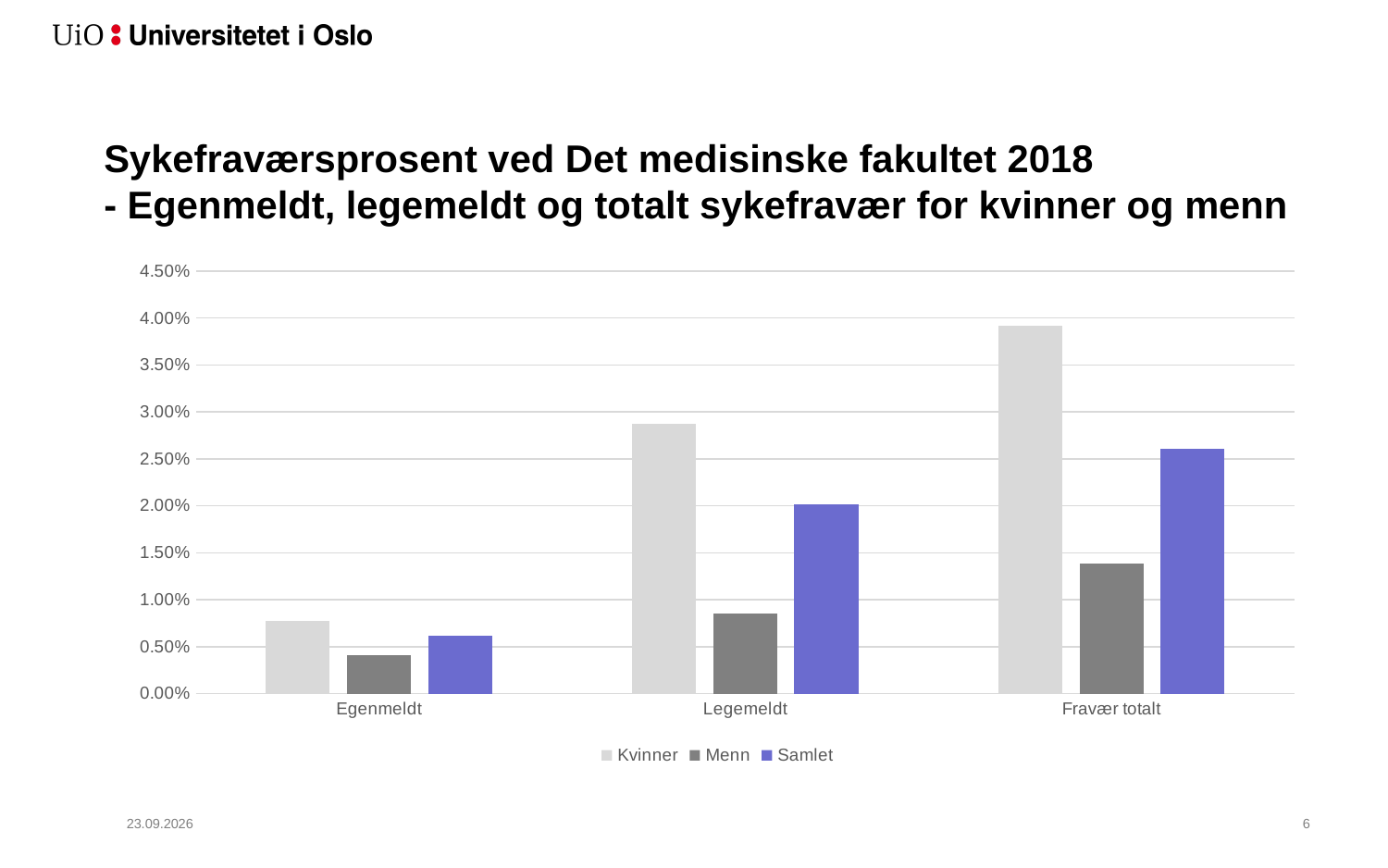
How many categories are shown on the x axis? 3 Which series has the lowest bar in the Egenmeldt category? Menn What are the three entries in the chart legend? Kvinner, Menn, Samlet How many series does the legend list? 3 In the Legemeldt category, which is larger: the value for Kvinner or the value for Menn? Kvinner Which series has the highest bar in the Fravær totalt category? Kvinner Is the value for Menn in Fravær totalt greater or less than 1.00%? greater Do the Kvinner values rise or fall from Egenmeldt to Fravær totalt along the x axis? rise Is the value for Samlet in Legemeldt greater or less than 1.50%? greater What kind of chart is shown on the slide? Bar chart Is the value for Menn in Legemeldt greater or less than 1.00%? less